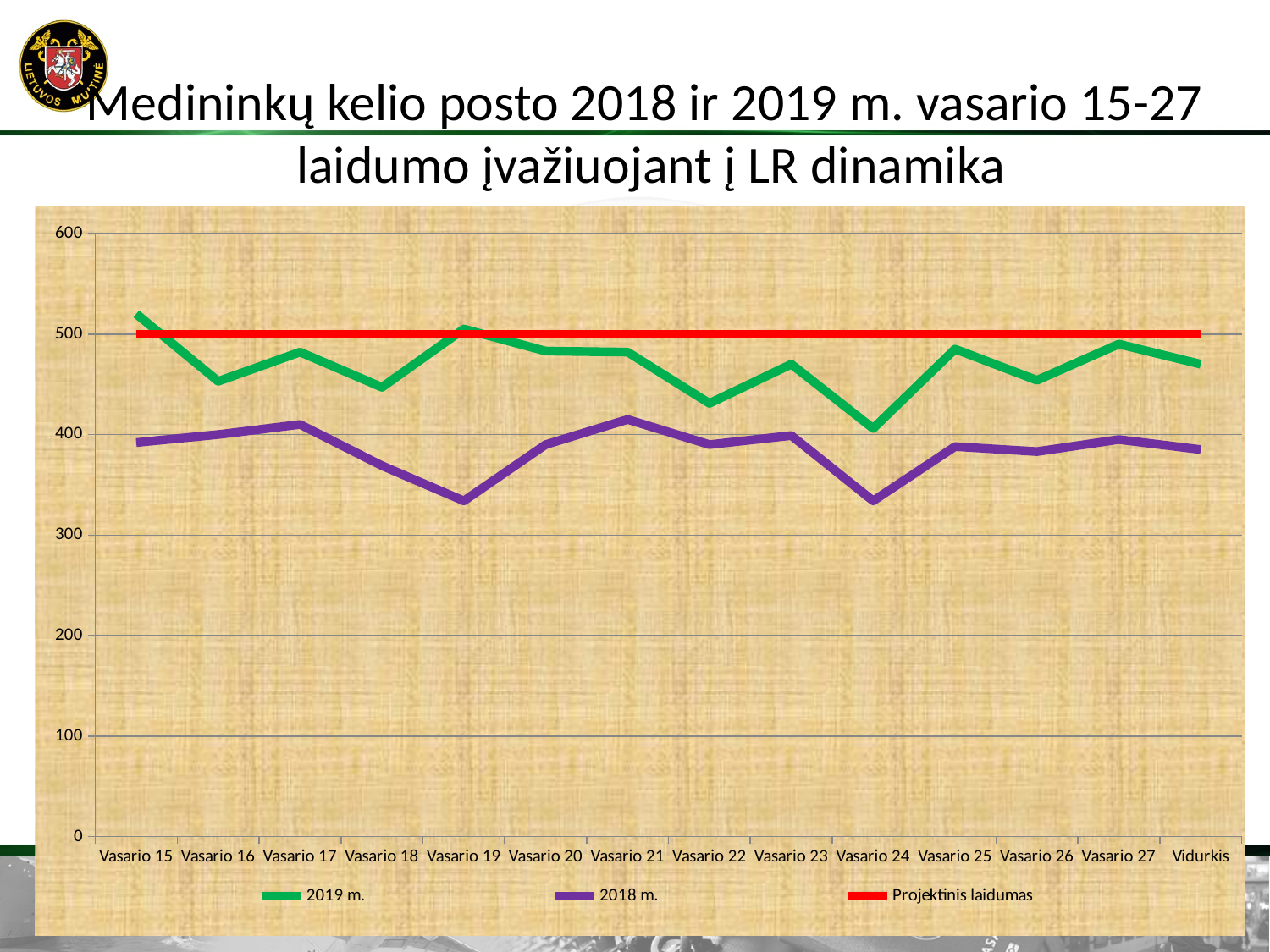
Which colour is used for the 2018 m. series? purple On which date does the 2019 m. series reach its lowest value? Vasario 24 How many series does the legend list? 3 On which date does the 2019 m. series reach its highest value? Vasario 15 What value does the Projektinis laidumas line sit at? 500 Is the value for 2019 m. on Vasario 15 greater or less than 500? greater What kind of chart is shown on the slide? line chart Is the value for 2019 m. on Vasario 22 greater or less than 500? less Does the 2018 m. series rise or fall from Vasario 17 to Vasario 19? fall How many categories are shown along the x axis? 14 On Vasario 20, which series has the larger value, 2019 m. or 2018 m.? 2019 m. Is the value for 2018 m. on Vasario 19 greater or less than 400? less